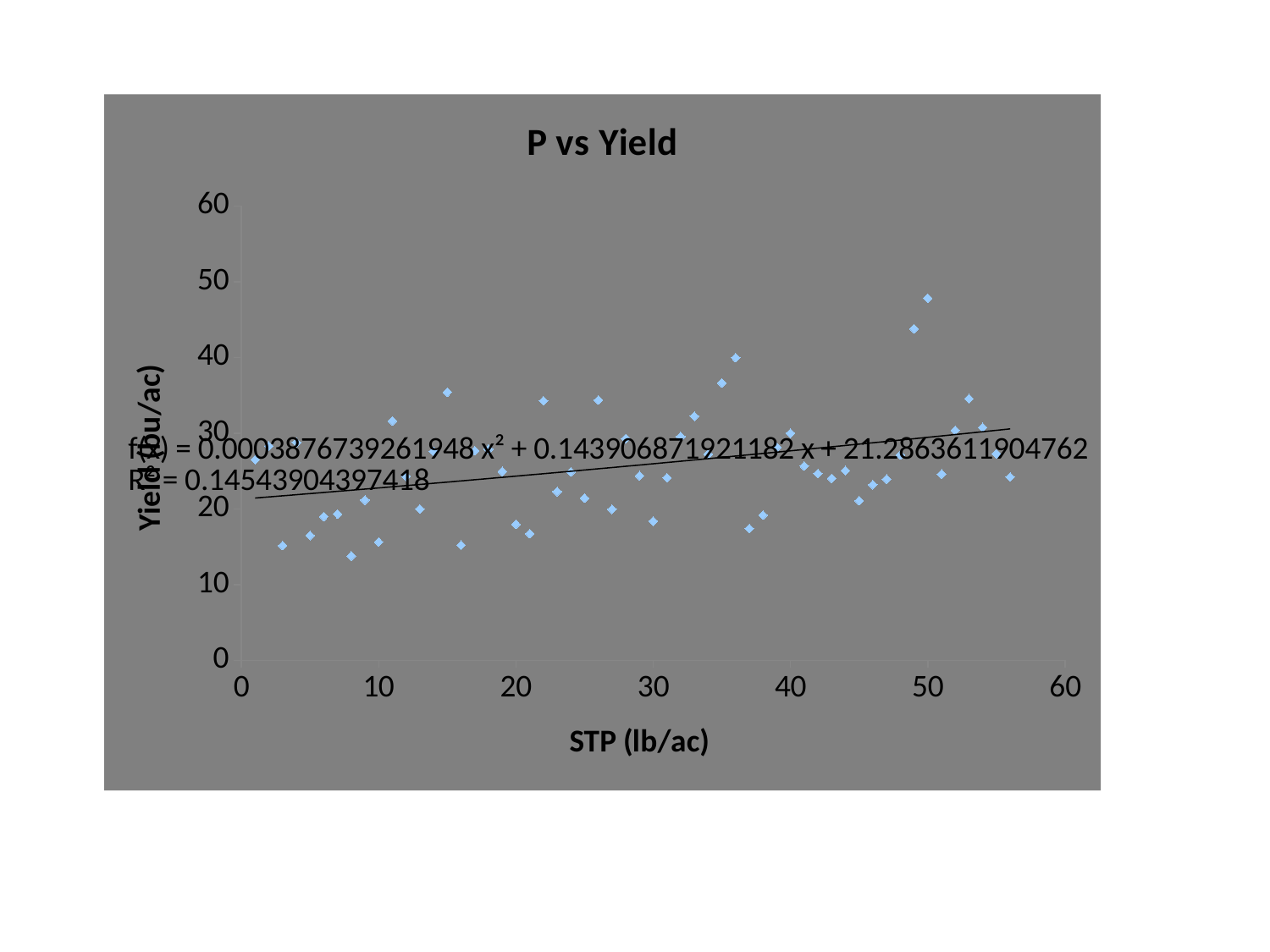
What is the highest value shown on the y axis? 60 What is the label of the x axis? STP (lb/ac) Is the yield of the highest point on the chart greater or less than 40? greater What is the title of the chart? P vs Yield What is the constant term in the trendline equation printed on the chart? 21.2863611904762 What R² value is printed on the chart? 0.14543904397418 Does the trendline rise or fall as STP increases along the x axis? rise Is the yield of the lowest point on the chart greater or less than 20? less What is the coefficient of x² in the trendline equation printed on the chart? 0.0003876739261948 What kind of chart is shown on the slide? scatter chart Is the STP value of the highest-yield point greater or less than 40? greater